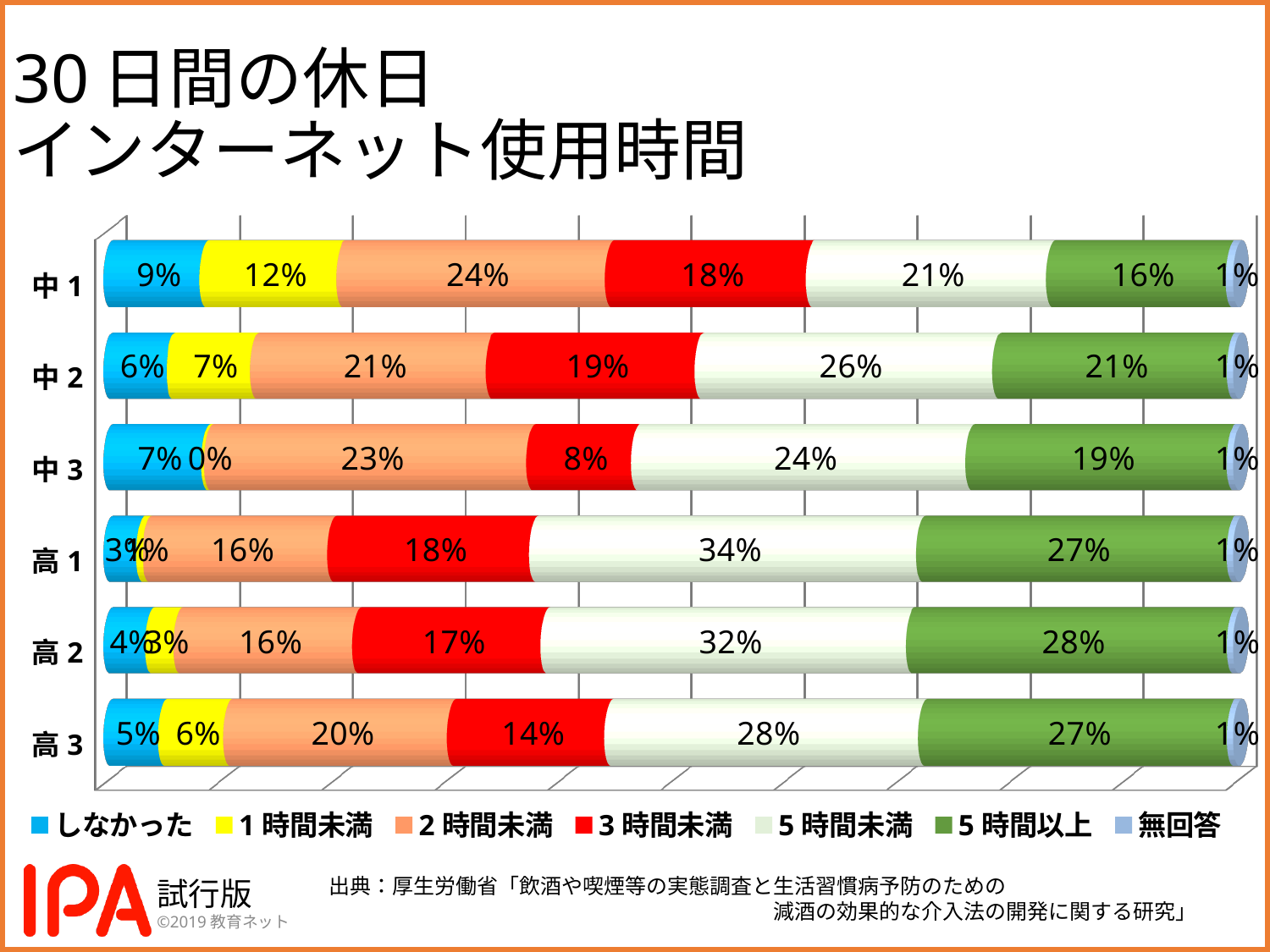
Which grade has the lowest value for 5時間以上? 中1 Which legend entry is shown in red? 3時間未満 What is the value of 3時間未満 for 中3? 8% Which is larger, the 3時間未満 value for 中2 or for 高3? 中2 What is the value of 2時間未満 for 中1? 24% How many series does the legend list? 7 What is the value of 5時間以上 for 高3? 27% What is the difference between the 5時間未満 values for 高1 and 中1? 13% How many grade categories are plotted on the chart? 6 What is the value of 5時間未満 for 中2? 26% What kind of chart is shown on the slide? stacked bar chart Which grade has the highest value for 5時間未満? 高1